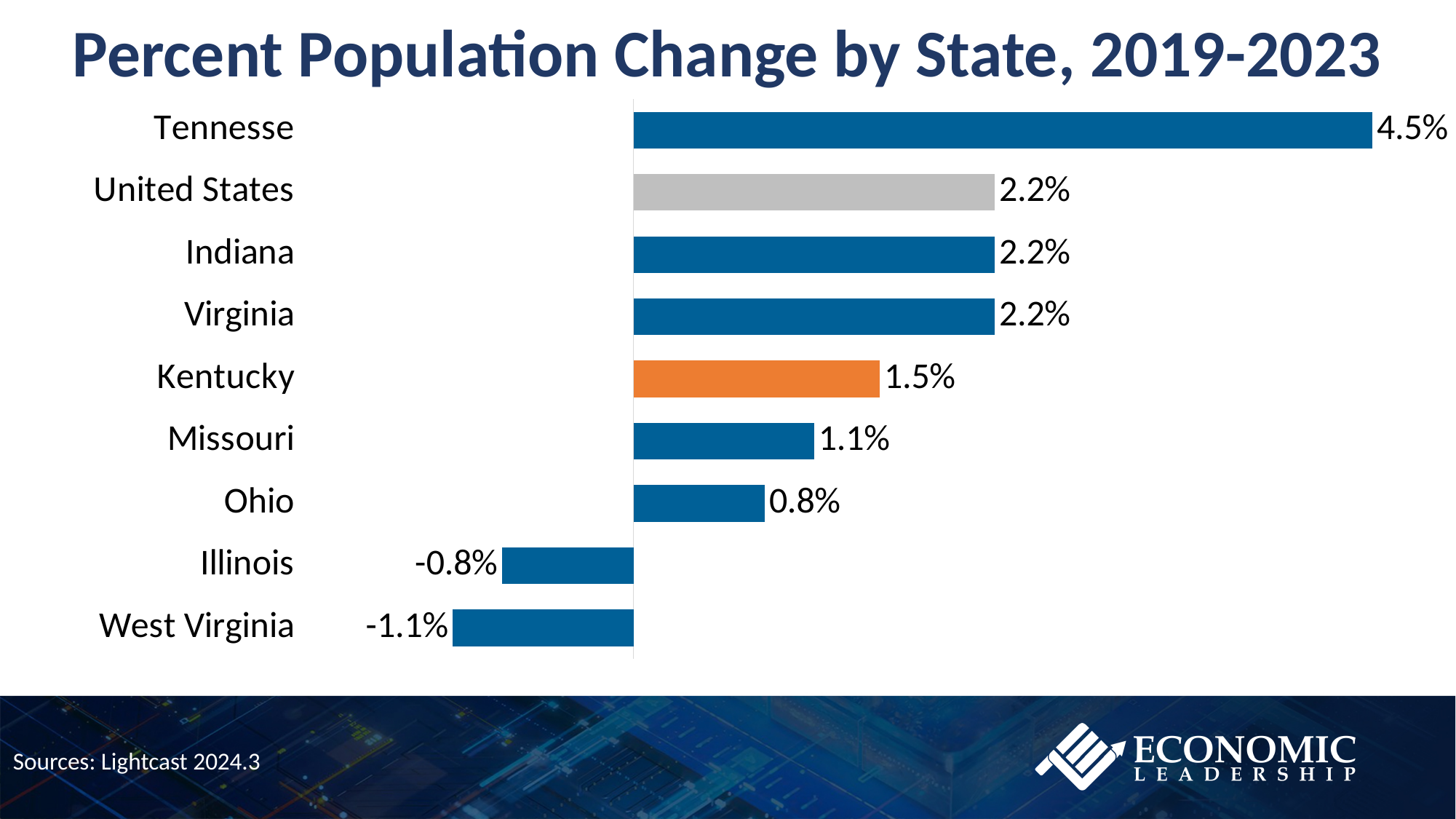
What is the title of the chart? Percent Population Change by State, 2019-2023 What is the percent population change for Kentucky? 1.5% Which category's bar is coloured orange? Kentucky What is the percent population change for West Virginia? -1.1% What kind of chart is shown on the slide? Bar chart Which category has the lowest percent population change? West Virginia Which has a larger percent population change, Missouri or Ohio? Missouri Which category has the highest percent population change? Tennesse What is the difference between the percent population change for Tennesse and Kentucky? 3.0% How many categories are shown in the chart? 9 What is the percent population change for Tennesse? 4.5% What is the percent population change for the United States? 2.2%